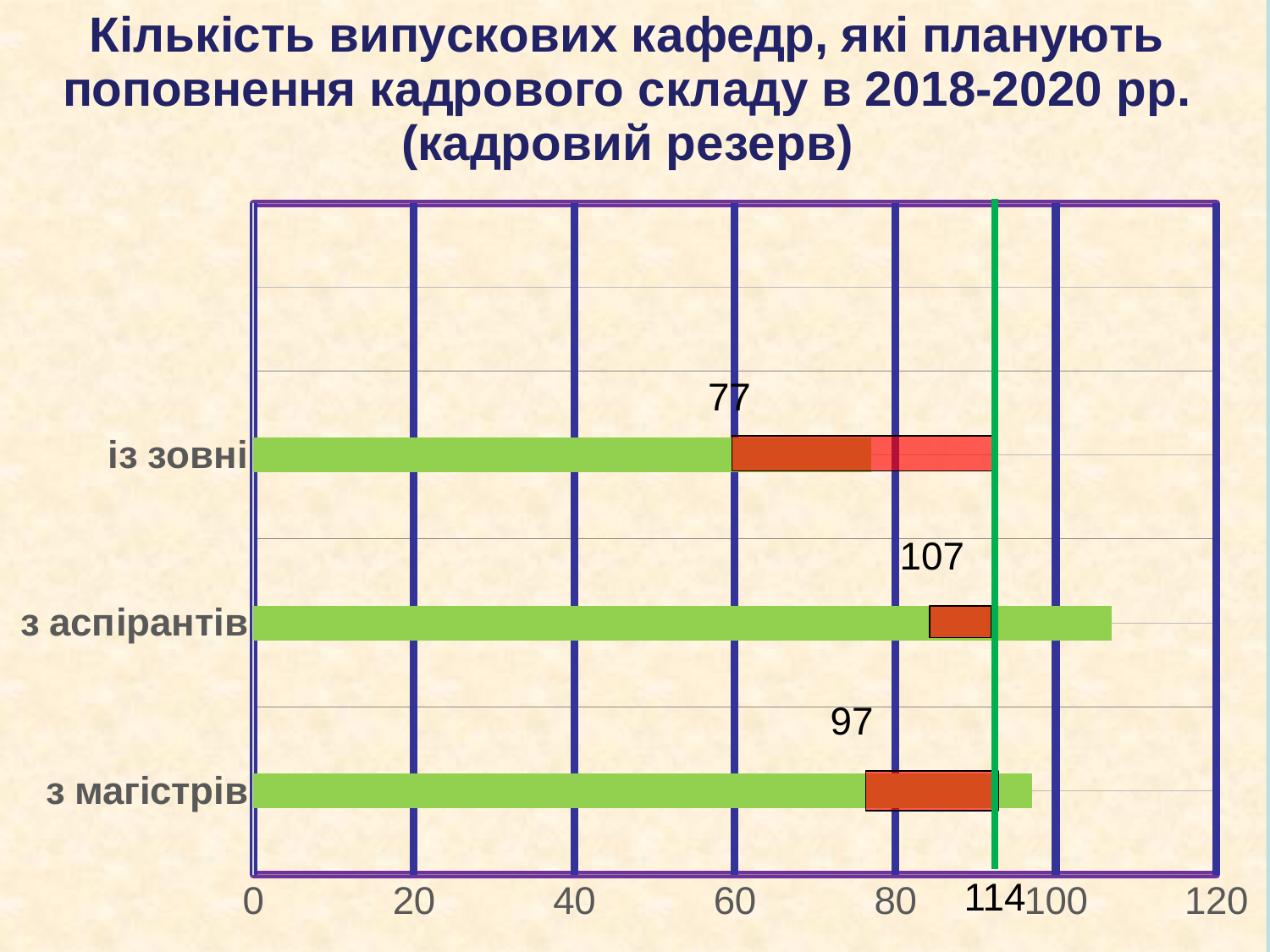
Which category has the highest value? з аспірантів What kind of chart is shown on the slide? bar chart Which category has the lowest value? із зовні What is the value for "з магістрів"? 97 Is the value for "з аспірантів" greater or less than 100? greater What is the difference between the values for "з аспірантів" and "із зовні"? 30 How many categories are shown in the chart? 3 Which is larger, the value for "з магістрів" or the value for "із зовні"? з магістрів What is the value for "з аспірантів"? 107 What value is marked by the green vertical line on the chart? 114 What is the value for "із зовні"? 77 What is the difference between the values for "з аспірантів" and "з магістрів"? 10